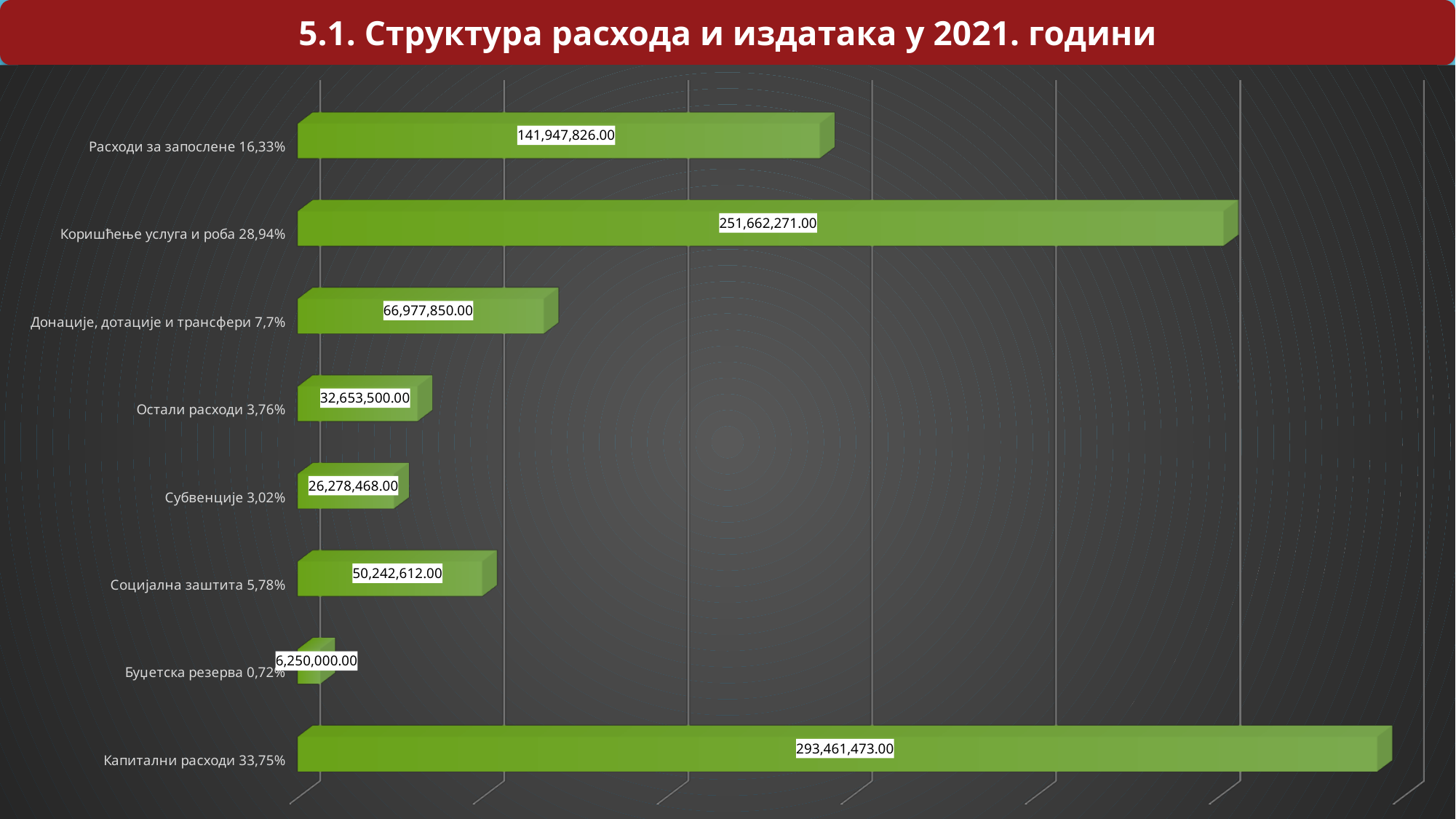
What is the difference between the values for Капитални расходи and Коришћење услуга и роба? 41,799,202.00 What is the value for Капитални расходи? 293,461,473.00 What is the value for Буџетска резерва? 6,250,000.00 Which is larger, the value for Остали расходи or the value for Субвенције? Остали расходи What kind of chart is shown on the slide? Bar chart Which category has the lowest value? Буџетска резерва What is the value for Социјална заштита? 50,242,612.00 What is the value for Коришћење услуга и роба? 251,662,271.00 What is the difference between the values for Донације, дотације и трансфери and Социјална заштита? 16,735,238.00 Which category has the highest value? Капитални расходи What percentage share is shown in the label for Расходи за запослене? 16,33% How many categories are shown in the chart? 8